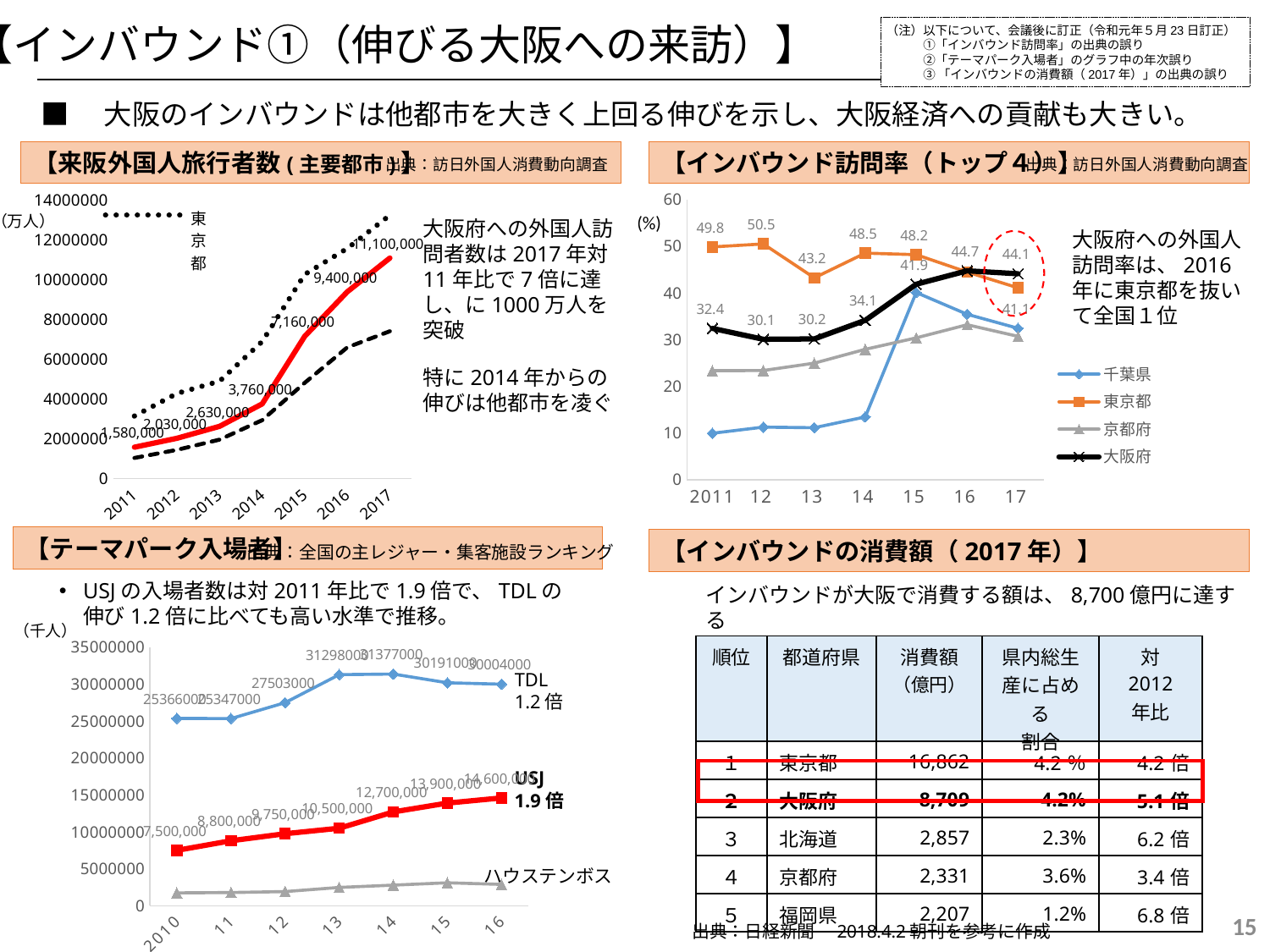
In the 来阪外国人旅行者数（主要都市） chart, what is the value labelled for 2014 on the red line? 3,760,000 How many series does the legend of the インバウンド訪問率（トップ4） chart list? 4 In the インバウンド訪問率（トップ4） chart, what is the value for 東京都 in 2011? 49.8 What kind of chart is the テーマパーク入場者 chart? line chart In the 来阪外国人旅行者数（主要都市） chart, what is the difference between the 2017 and 2016 values on the red line? 1,700,000 In the インバウンド訪問率（トップ4） chart, which is larger in 2011, 東京都 or 大阪府? 東京都 In the 来阪外国人旅行者数（主要都市） chart, do the values on the red line rise or fall from 2011 to 2017? rise In the テーマパーク入場者 chart, what is the difference between the USJ values for 2016 and 2010? 7,100,000 In the インバウンド訪問率（トップ4） chart, what is the value for 大阪府 in 2015? 41.9 In the テーマパーク入場者 chart, what is the value for USJ in 2016? 14,600,000 In the インバウンド訪問率（トップ4） chart, is the value for 千葉県 in 2011 greater or less than 20? less In the 来阪外国人旅行者数（主要都市） chart, what is the value for 2017 on the red line? 11,100,000